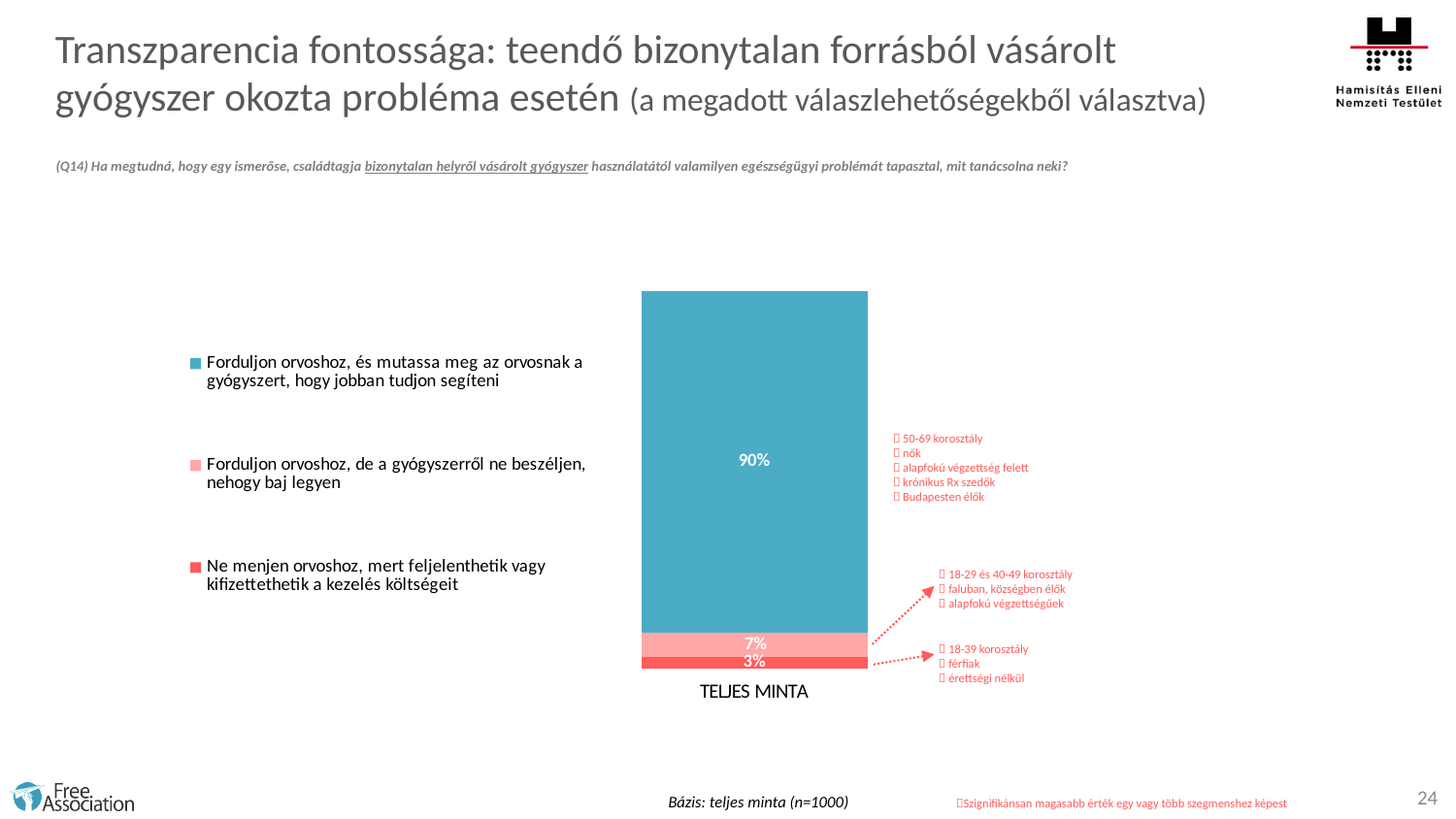
Which is larger: the share for "Forduljon orvoshoz, de a gyógyszerről ne beszéljen" or the share for "Ne menjen orvoshoz"? Forduljon orvoshoz, de a gyógyszerről ne beszéljen What kind of chart is shown on the slide? Stacked bar chart What is the difference between the share for "Forduljon orvoshoz, de a gyógyszerről ne beszéljen" and the share for "Ne menjen orvoshoz"? 4% What percentage of respondents chose "Ne menjen orvoshoz, mert feljelenthetik vagy kifizettethetik a kezelés költségeit"? 3% What percentage of respondents chose "Forduljon orvoshoz, és mutassa meg az orvosnak a gyógyszert, hogy jobban tudjon segíteni"? 90% Which response option has the highest share in the chart? Forduljon orvoshoz, és mutassa meg az orvosnak a gyógyszert, hogy jobban tudjon segíteni How many series does the legend list? 3 Which response option has the lowest share in the chart? Ne menjen orvoshoz, mert feljelenthetik vagy kifizettethetik a kezelés költségeit What is the label of the single category shown on the x axis of the chart? TELJES MINTA What is the difference between the largest and smallest segments of the bar? 87% What percentage of respondents chose "Forduljon orvoshoz, de a gyógyszerről ne beszéljen, nehogy baj legyen"? 7% What is the total of the three segments in the TELJES MINTA bar? 100%